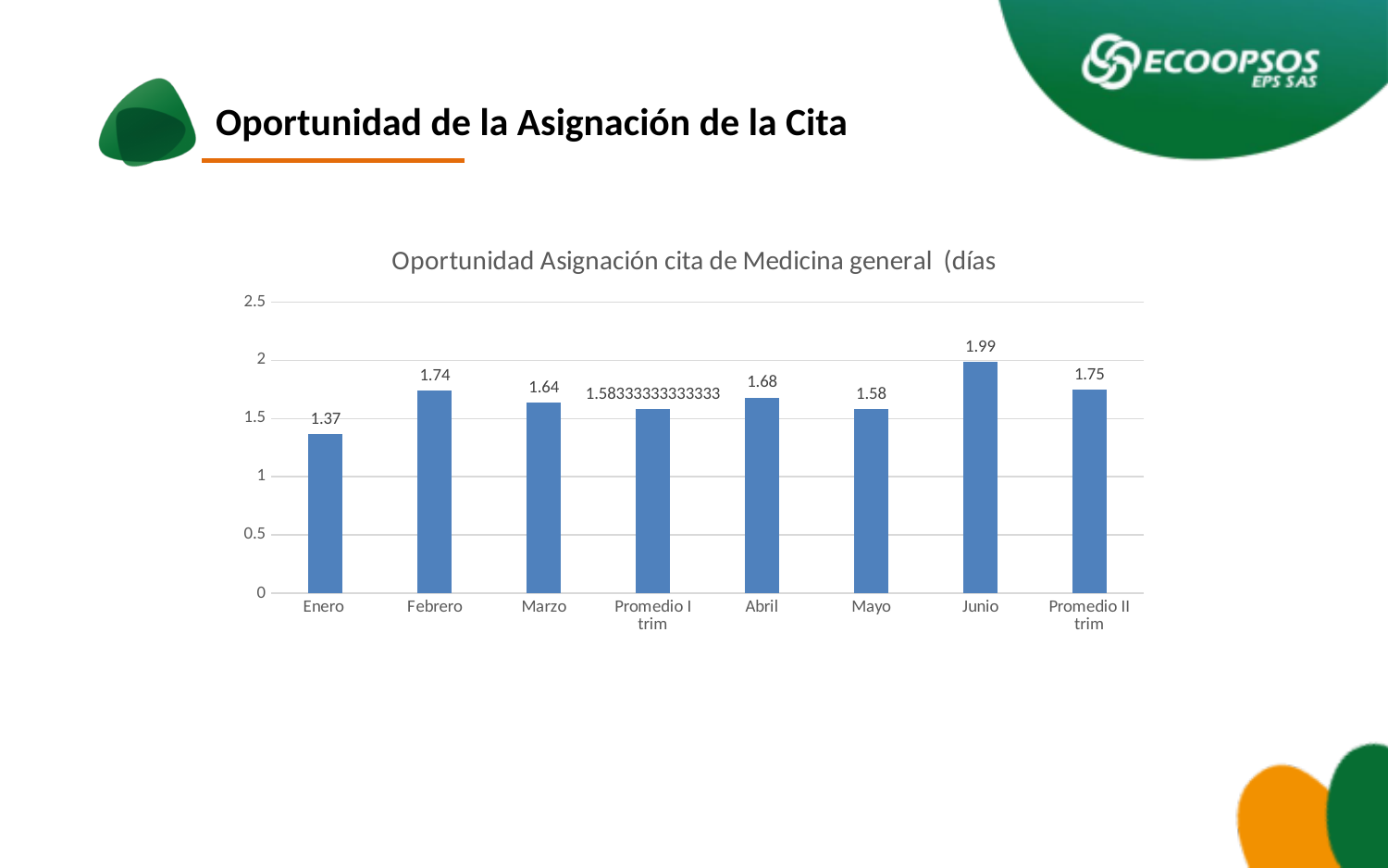
What is the difference between the values for Junio and Enero? 0.62 What is the title of the chart? Oportunidad Asignación cita de Medicina general (días What is the value for Promedio II trim? 1.75 What kind of chart is shown on the slide? bar chart Which is larger, the value for Febrero or the value for Marzo? Febrero Which category has the highest value? Junio What is the value for Promedio I trim? 1.58333333333333 Which category has the lowest value? Enero How many categories are shown on the x axis? 8 What is the value for Junio? 1.99 Is the value for Mayo greater or less than 2? less What is the value for Enero? 1.37